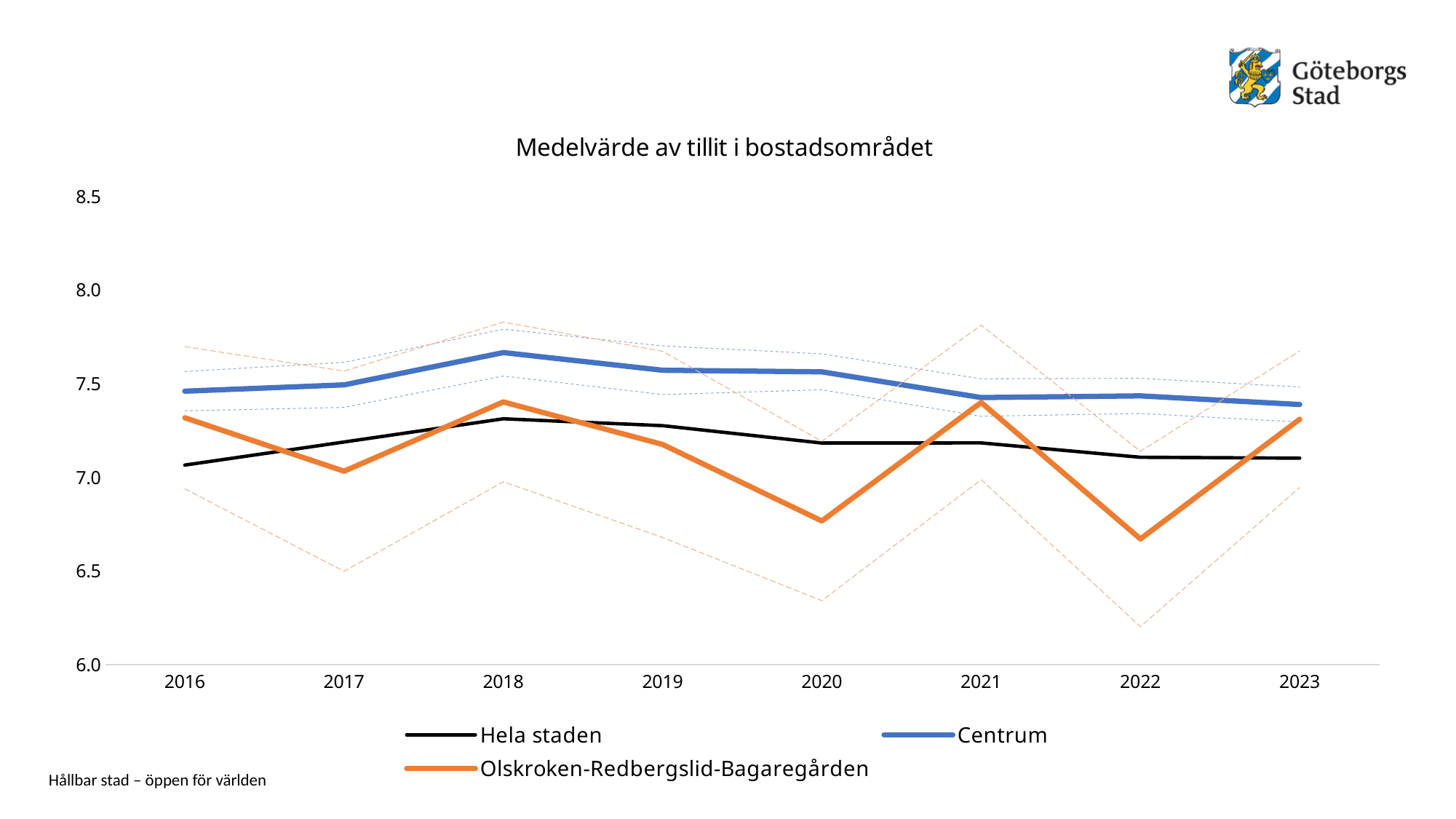
How many series does the legend list? 3 Is the value for Centrum in 2018 greater or less than 7.5? greater In which year does the Centrum line reach its highest value? 2018 Is the value for Olskroken-Redbergslid-Bagaregården in 2020 greater or less than 7.0? less How many years are shown on the x axis? 8 What kind of chart is shown on the slide? line chart In which year does the Olskroken-Redbergslid-Bagaregården line reach its lowest value? 2022 In 2017, which is larger: Hela staden or Olskroken-Redbergslid-Bagaregården? Hela staden What is the title of the chart? Medelvärde av tillit i bostadsområdet In 2020, which is larger: Centrum or Olskroken-Redbergslid-Bagaregården? Centrum Is the value for Hela staden in 2016 greater or less than 7.0? greater Does the Centrum line rise or fall from 2018 to 2023? fall